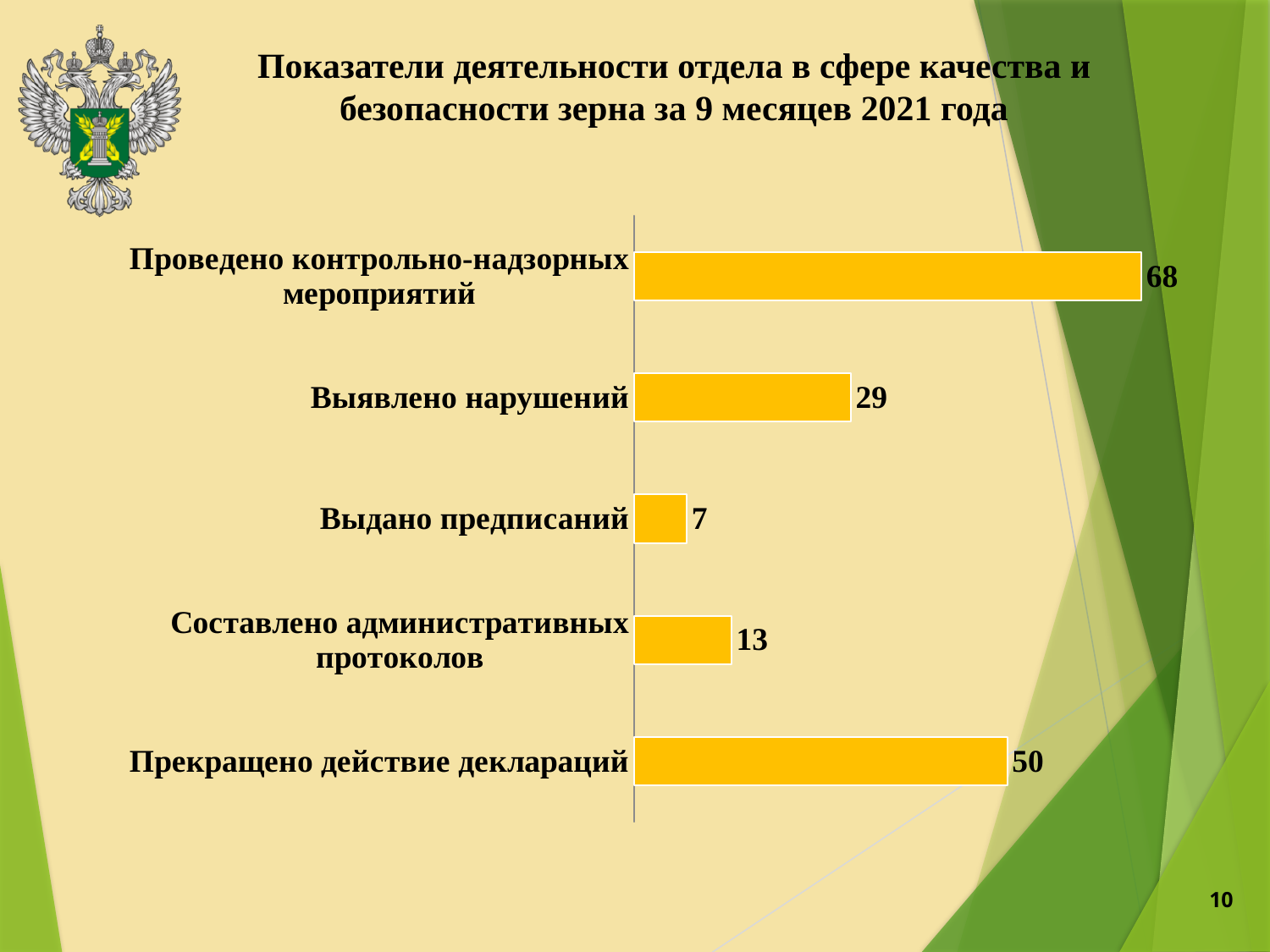
What is the value for "Прекращено действие деклараций"? 50 What is the value for "Составлено административных протоколов"? 13 How many categories are shown in the chart? 5 Which category has the lowest value? Выдано предписаний Which category has the highest value? Проведено контрольно-надзорных мероприятий What is the value for "Выявлено нарушений"? 29 What kind of chart is shown on the slide? Bar chart Which is larger: the value for "Выявлено нарушений" or the value for "Составлено административных протоколов"? Выявлено нарушений What is the difference between the values for "Проведено контрольно-надзорных мероприятий" and "Прекращено действие деклараций"? 18 What is the difference between the values for "Выявлено нарушений" and "Составлено административных протоколов"? 16 What is the value for "Выдано предписаний"? 7 What is the value for "Проведено контрольно-надзорных мероприятий"? 68